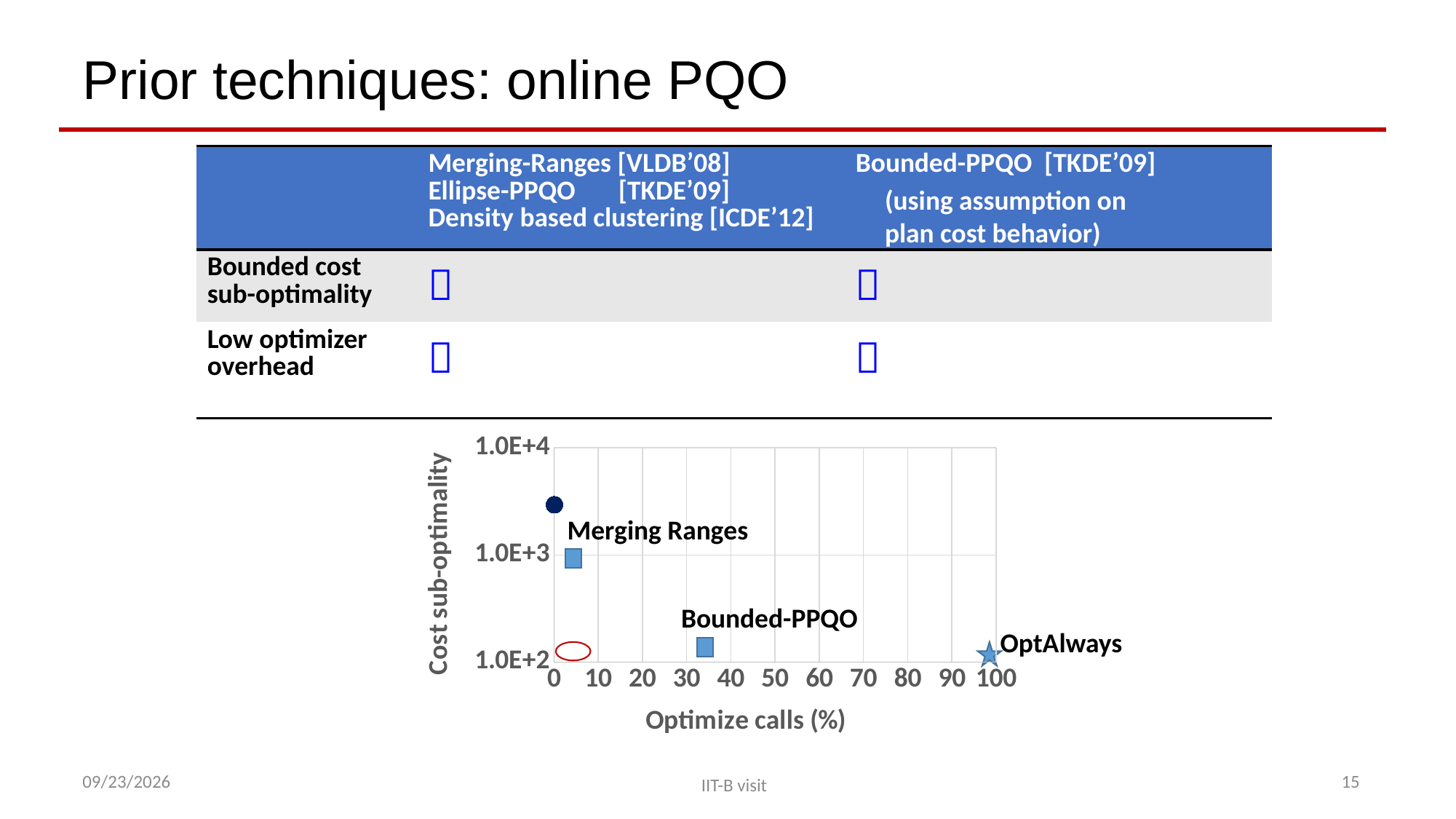
Which labeled technique has the lowest Optimize calls (%)? Merging Ranges Which labeled technique has the highest Cost sub-optimality? Merging Ranges What is the label of the x axis of the chart? Optimize calls (%) Which has the higher Cost sub-optimality, Merging Ranges or Bounded-PPQO? Merging Ranges Is the Optimize calls (%) value for Merging Ranges greater or less than 10? less Which labeled technique has the highest Optimize calls (%)? OptAlways Is the Optimize calls (%) value for OptAlways greater or less than 90? greater How many labeled techniques are plotted on the chart? 3 What kind of chart is shown on the slide? scatter chart Is the Cost sub-optimality for Bounded-PPQO greater or less than 1.0E+3? less What is the label of the y axis of the chart? Cost sub-optimality